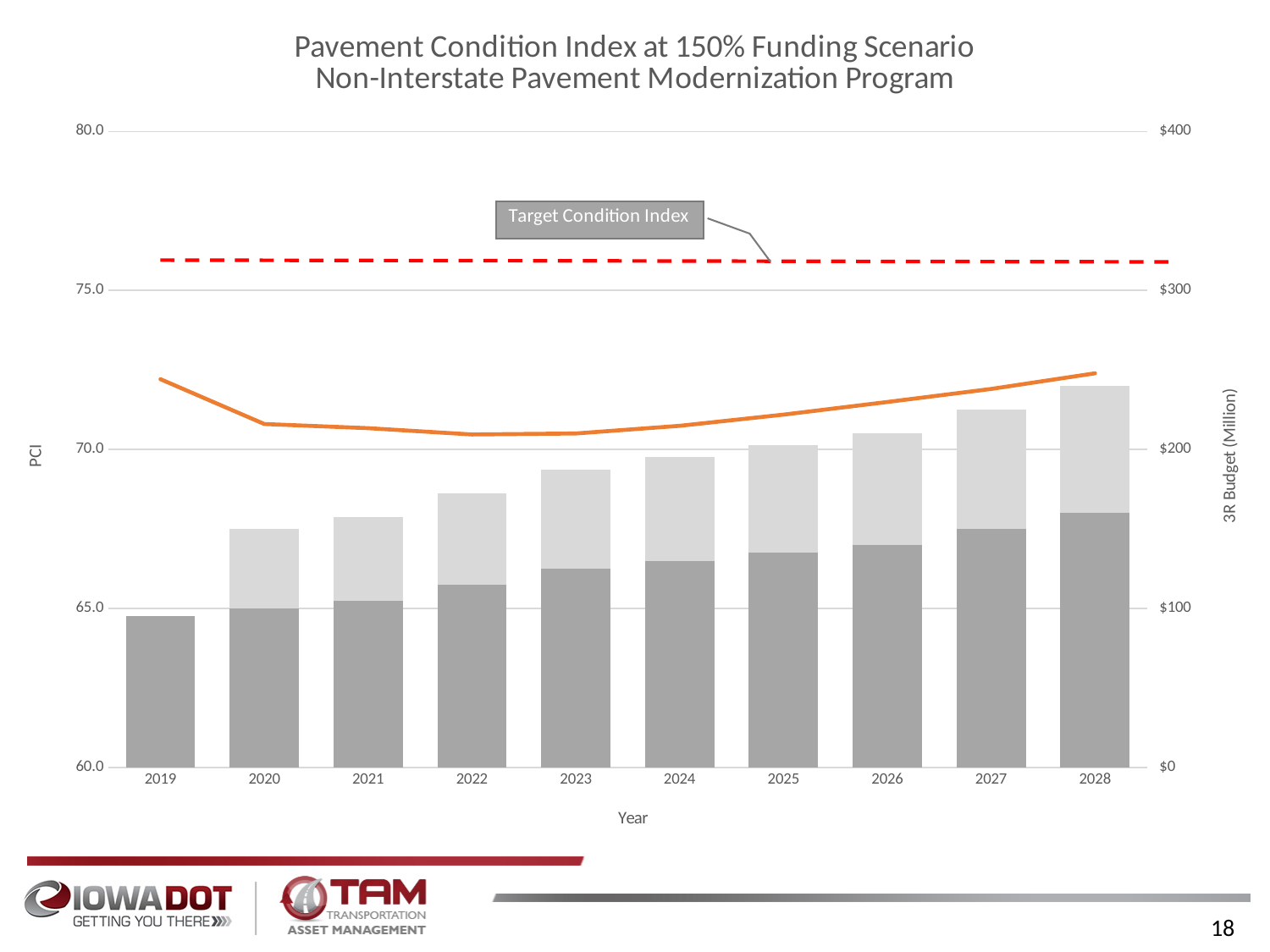
Is the orange PCI line value for 2019 greater or less than 70.0? greater What kind of chart is shown on the slide? A combination chart with stacked bars and lines How many years are shown on the x axis of the chart? 10 Is the total of the stacked bar for 2022 greater or less than $200 on the right axis? less Is the total of the stacked bar for 2019 greater or less than $100 on the right axis? less What is the title of the chart? Pavement Condition Index at 150% Funding Scenario Non-Interstate Pavement Modernization Program Which year has the tallest stacked bar? 2028 Which year has the shortest stacked bar? 2019 Do the stacked bars rise or fall from 2019 to 2028? rise What is the label of the right-hand vertical axis? 3R Budget (Million)